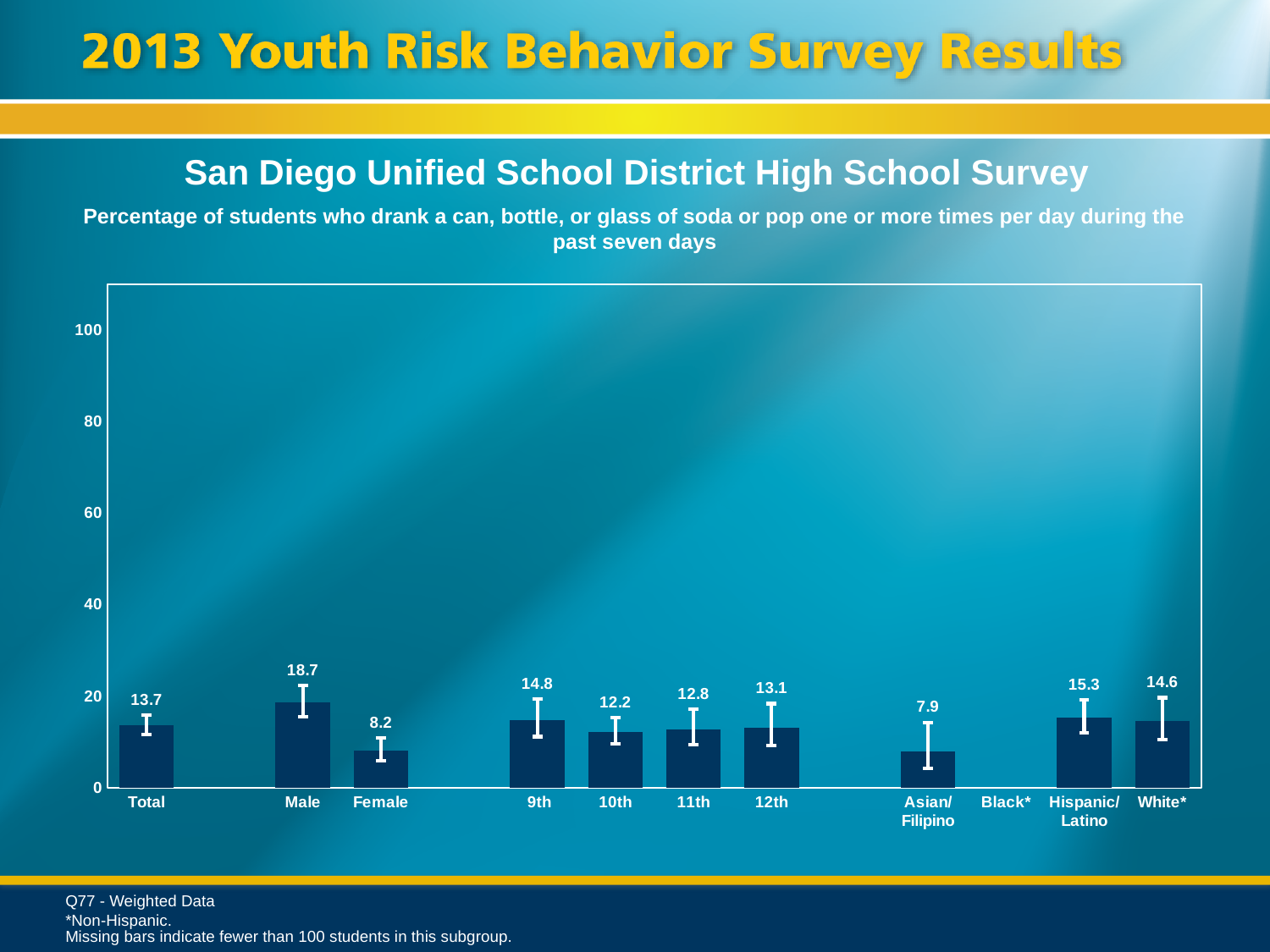
What is the value for Total? 13.7 What kind of chart is this? bar chart Which category has no bar plotted? Black* What is the difference between the Male and Female values? 10.5 What is the value for Asian/Filipino? 7.9 How many categories are labeled on the x axis? 11 Is the value for Hispanic/Latino greater or less than 20? less Which category has the highest value? Male Which is larger, the value for 9th or the value for 10th? 9th What is the value for Male? 18.7 Which category with a plotted bar has the lowest value? Asian/Filipino What is the value for Female? 8.2